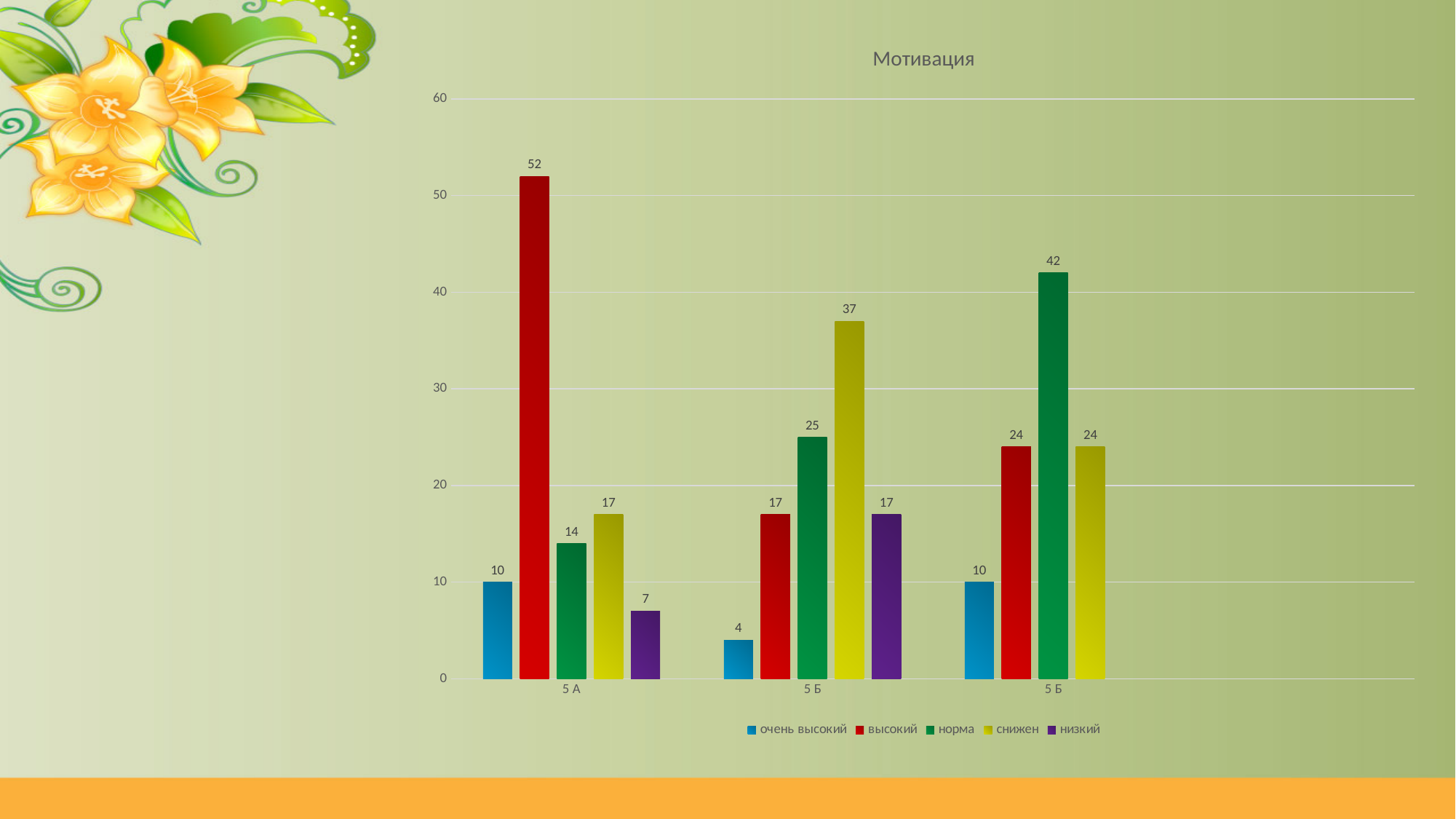
What is the value of the 'норма' series in the rightmost category group? 42 How many series does the legend list? 5 Is the 'снижен' value in the middle category group greater or less than 30? greater Which is larger in the rightmost category group: the 'норма' value or the 'высокий' value? норма What is the value of the 'высокий' series for the first category group, '5 А'? 52 Which series has the highest value in the '5 А' group? высокий How many category groups are shown along the x axis? 3 What type of chart is shown on the slide? bar chart What is the difference between the 'высокий' value and the 'норма' value in the '5 А' group? 38 What is the title of the chart? Мотивация Which series has the lowest value in the middle category group (the first '5 Б')? очень высокий What is the value of the 'снижен' series in the middle category group (the first '5 Б')? 37